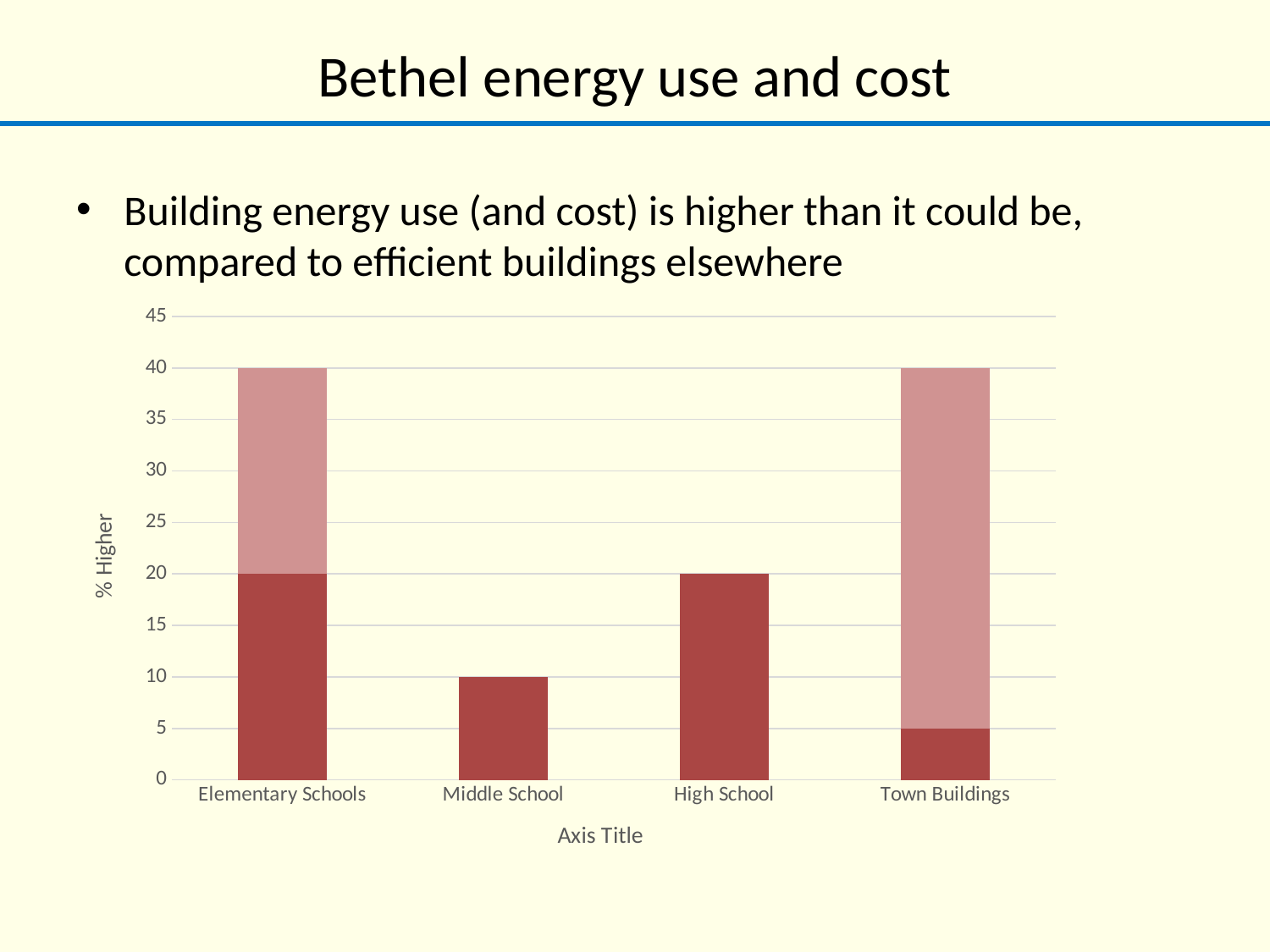
What kind of chart is shown on the slide? Stacked bar chart What is the difference between the dark red segments for High School and Middle School? 10 What is the title of the vertical axis of the chart? % Higher What is the value of the dark red segment for Elementary Schools? 20 What is the value of the dark red segment for Town Buildings? 5 Which has a larger dark red segment, Middle School or High School? High School How many categories are shown on the x axis of the chart? 4 Which category has the smallest dark red segment? Town Buildings What is the value of the dark red segment for Middle School? 10 What is the total height of the stacked bar for Town Buildings? 40 What is the total height of the stacked bar for Elementary Schools? 40 What is the value of the dark red segment for High School? 20